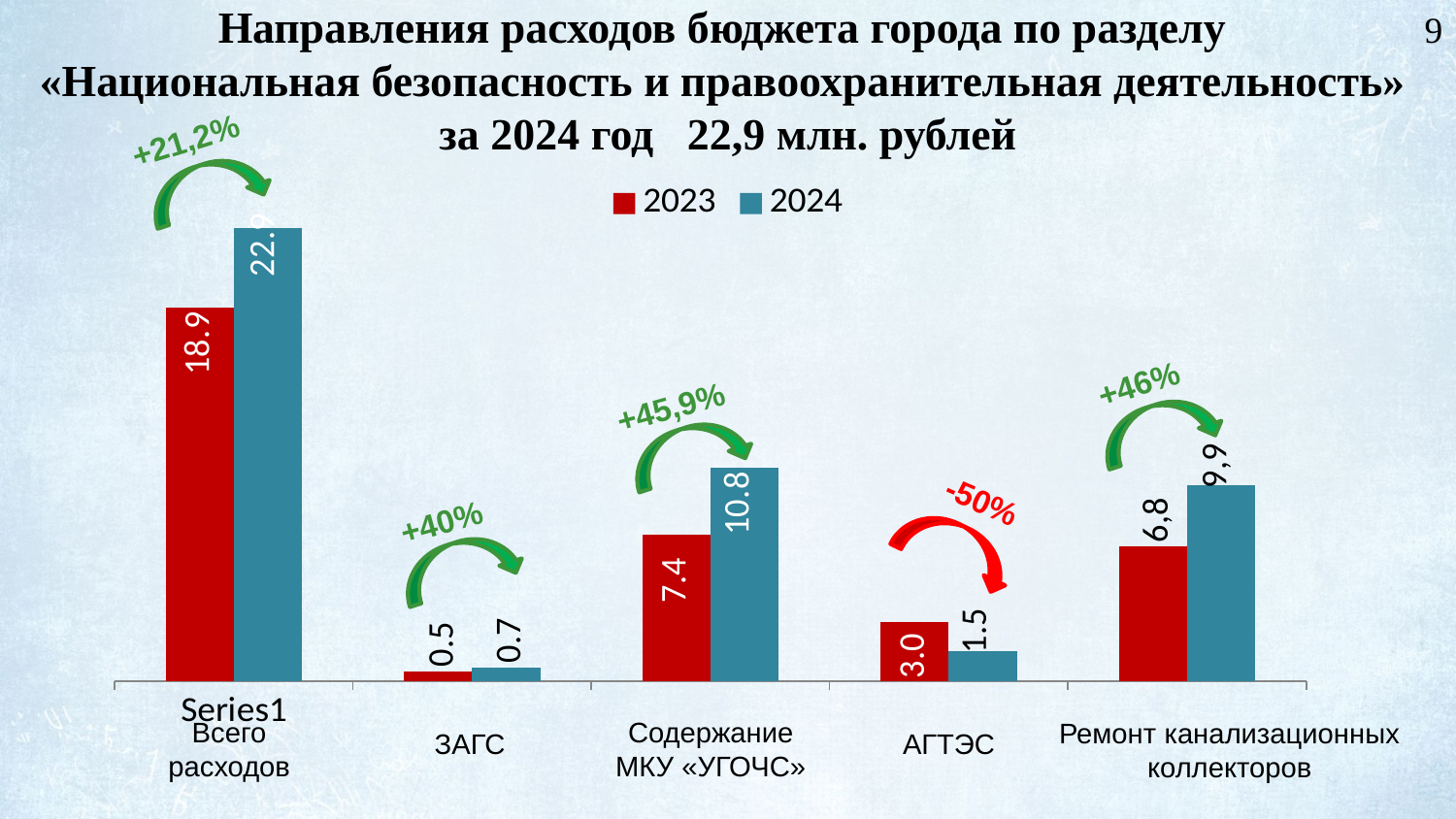
Which category has the lowest 2023 value? ЗАГС How many series does the legend list? 2 Which category has the highest 2024 value? Всего расходов How many categories are shown on the x axis? 5 What kind of chart is shown on the slide? bar chart What is the 2023 value for Содержание МКУ «УГОЧС»? 7.4 What is the 2023 value for Всего расходов? 18.9 What is the difference between the 2024 and 2023 values for Содержание МКУ «УГОЧС»? 3.4 What is the 2024 value for Ремонт канализационных коллекторов? 9,9 What percentage change is annotated above the АГТЭС bars? -50% What is the 2024 value for АГТЭС? 1.5 For АГТЭС, which year has the larger value, 2023 or 2024? 2023